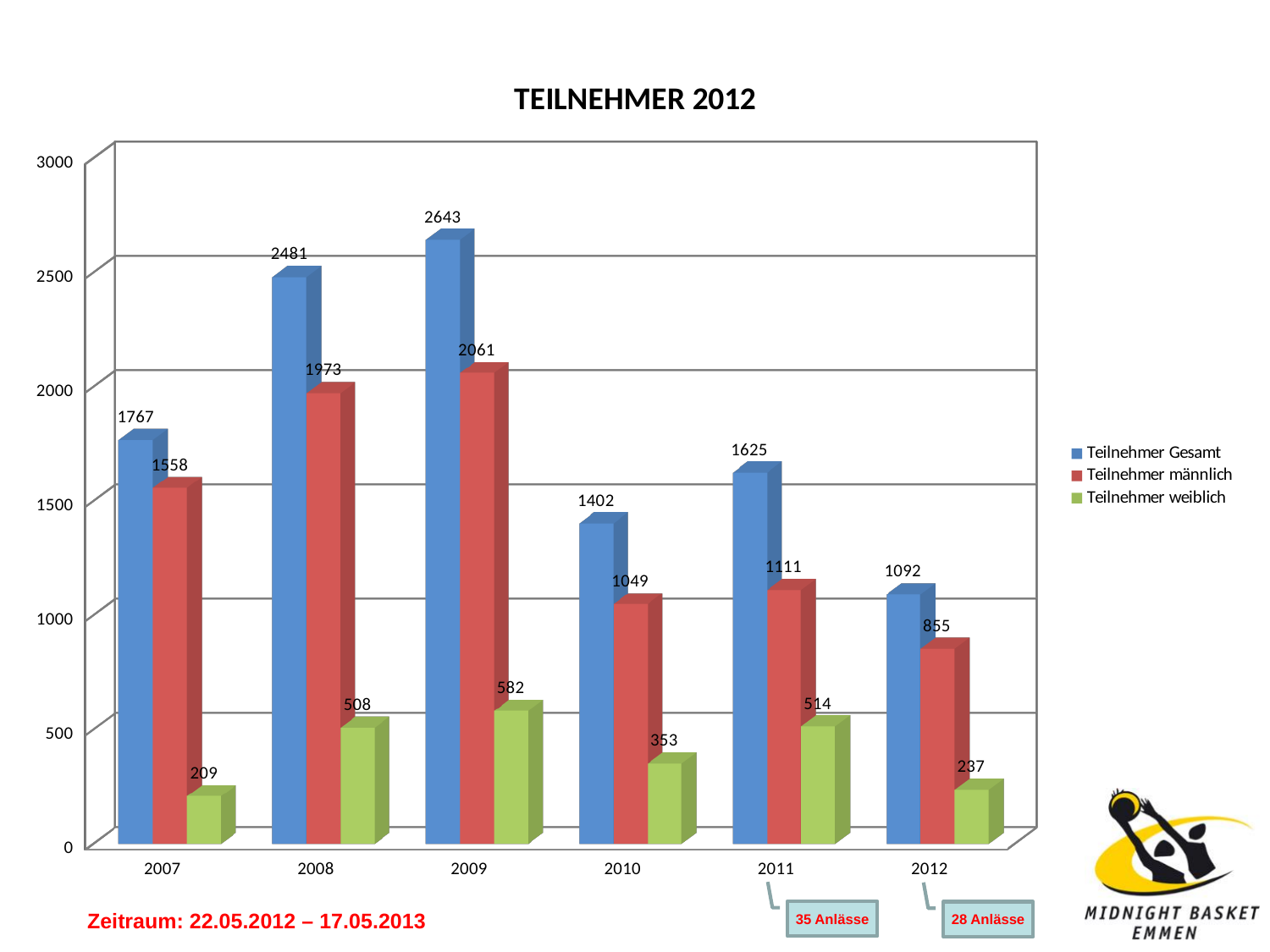
Which is larger: Teilnehmer männlich in 2010 or Teilnehmer männlich in 2011? Teilnehmer männlich in 2011 What is the difference between Teilnehmer Gesamt in 2008 and in 2012? 1389 Which year has the highest Teilnehmer Gesamt? 2009 What is the value of Teilnehmer Gesamt for 2009? 2643 Is the value of Teilnehmer Gesamt for 2011 greater or less than 1500? greater What is the value of Teilnehmer männlich for 2012? 855 Which year has the lowest Teilnehmer weiblich? 2007 What is the value of Teilnehmer weiblich for 2010? 353 How many years are shown on the x axis? 6 What kind of chart is shown on the slide? bar chart What is the title of the chart? TEILNEHMER 2012 How many series does the legend list? 3